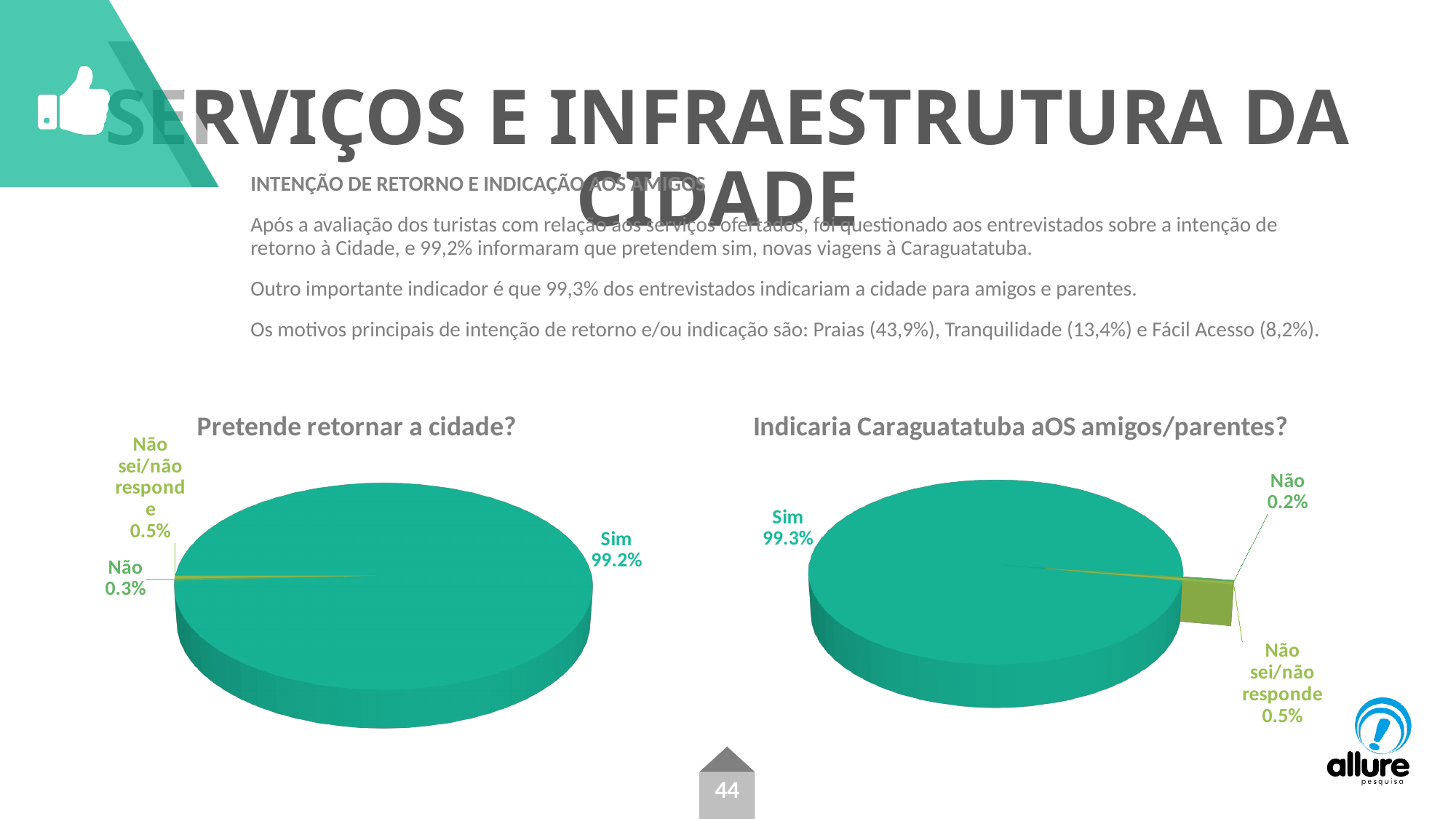
In the chart titled "Indicaria Caraguatatuba aOS amigos/parentes?", which category has the smallest slice? Não In the chart titled "Indicaria Caraguatatuba aOS amigos/parentes?", which is larger: the "Não" slice or the "Não sei/não responde" slice? Não sei/não responde In the chart titled "Pretende retornar a cidade?", what share of respondents answered "Sim"? 99.2% What type of chart is the chart titled "Indicaria Caraguatatuba aOS amigos/parentes?"? Pie chart In the chart titled "Pretende retornar a cidade?", which category has the largest slice? Sim In the chart titled "Pretende retornar a cidade?", what is the difference between the "Não sei/não responde" share and the "Não" share? 0.2% In the chart titled "Indicaria Caraguatatuba aOS amigos/parentes?", what share is labelled "Não sei/não responde"? 0.5% In the chart titled "Indicaria Caraguatatuba aOS amigos/parentes?", what share of respondents answered "Não"? 0.2% In the chart titled "Pretende retornar a cidade?", what share of respondents answered "Não"? 0.3% In the chart titled "Indicaria Caraguatatuba aOS amigos/parentes?", what share of respondents answered "Sim"? 99.3% How many categories are shown in the chart titled "Pretende retornar a cidade?"? 3 In the chart titled "Pretende retornar a cidade?", what share is labelled "Não sei/não responde"? 0.5%